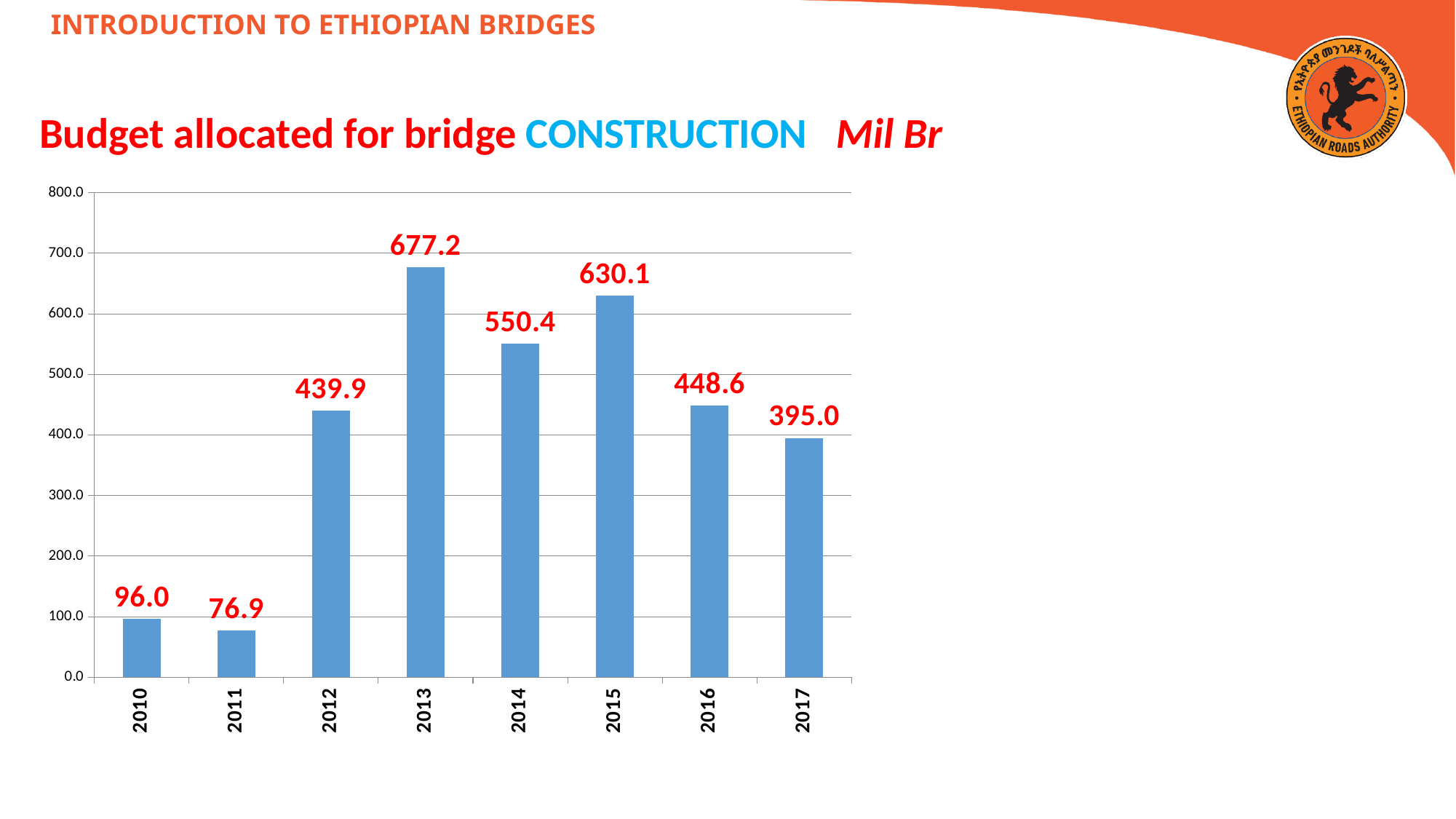
What is the budget allocated for bridge construction in 2013? 677.2 What is the budget allocated for bridge construction in 2010? 96.0 What kind of chart is shown on the slide? bar chart Is the budget for 2017 greater or less than 400.0? less What is the difference between the budget in 2012 and the budget in 2011? 363.0 What is the difference between the budget in 2013 and the budget in 2015? 47.1 What is the budget allocated for bridge construction in 2016? 448.6 Which year has a larger budget, 2014 or 2016? 2014 Does the budget rise or fall from 2015 to 2017? fall How many years are shown on the x axis of the chart? 8 Which year has the highest budget allocated for bridge construction? 2013 Which year has the lowest budget allocated for bridge construction? 2011